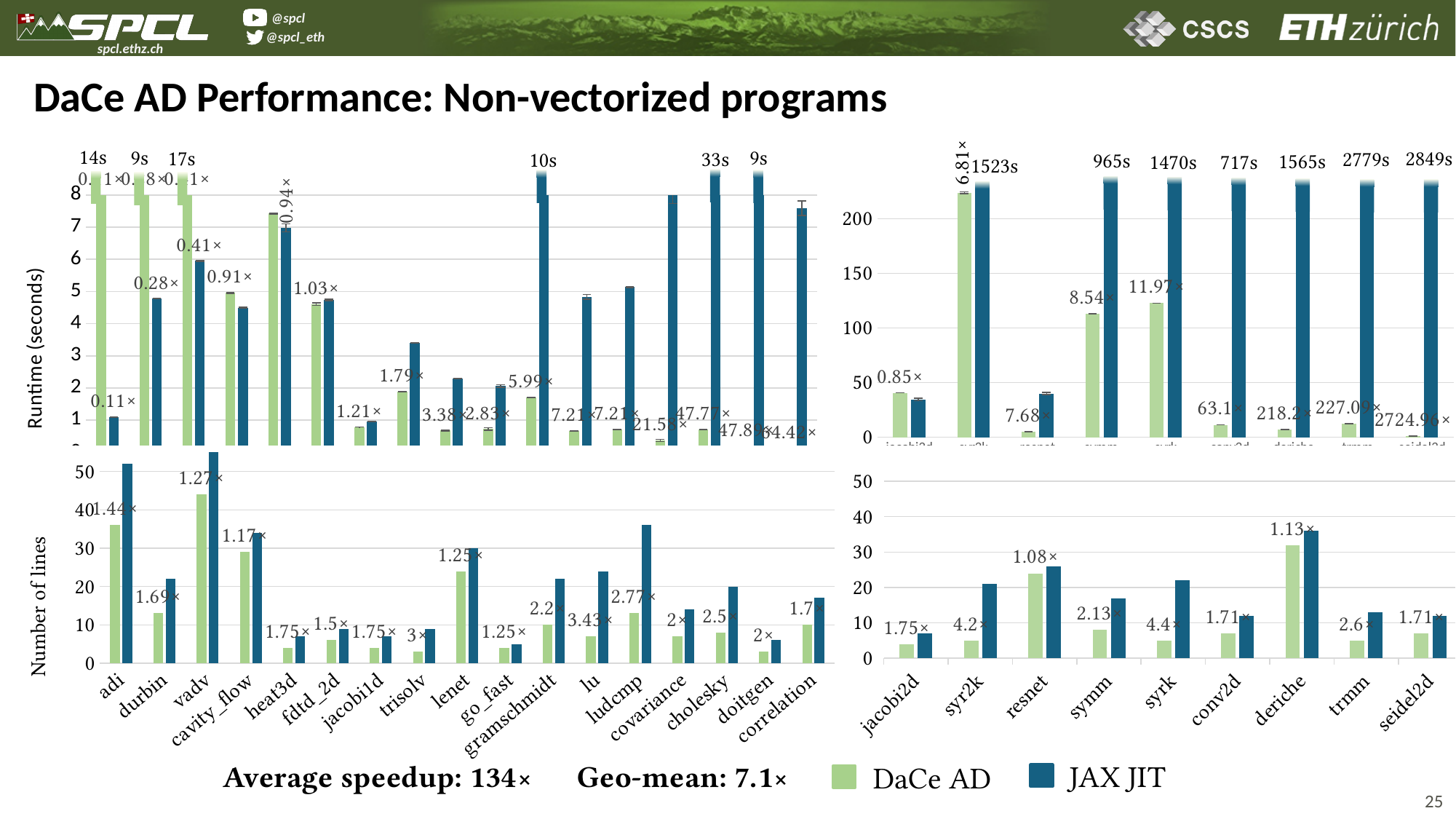
In the top-right runtime chart, what runtime is printed above the JAX JIT bar for seidel2d? 2849s In the bottom-right chart (number of lines), how many programs are shown on the x axis? 9 In the bottom-right number-of-lines chart, for resnet, which series has the larger value, DaCe AD or JAX JIT? JAX JIT In the bottom-right number-of-lines chart, is the JAX JIT value for deriche greater or less than 30? greater What kind of chart is the bottom-right chart (number of lines for jacobi2d through seidel2d)? bar chart In the bottom-left number-of-lines chart, what ratio label is printed for ludcmp? 2.77× In the top-left runtime chart, what speedup label is printed for go_fast? 2.83× How many series does the legend at the bottom of the slide list? 2 In the bottom-right number-of-lines chart, which program has the highest JAX JIT bar? deriche What average speedup is stated in the text below the charts? 134× In the top-right runtime chart, what speedup label is printed for syrk? 11.97× In the bottom-left chart (number of lines), how many programs are shown on the x axis? 17